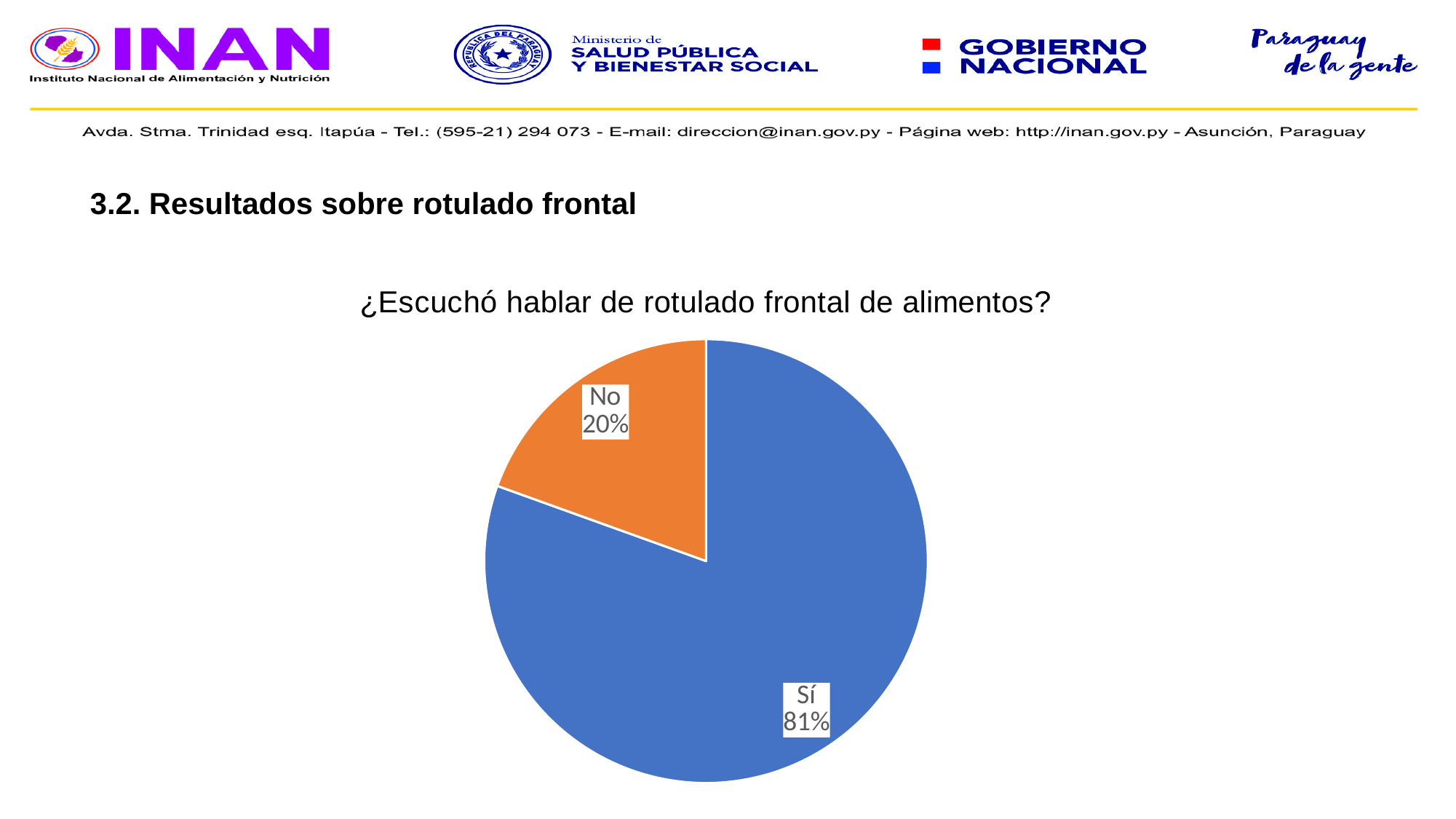
What kind of chart is shown on the slide? Pie chart How many slices does the pie chart have? 2 What is the difference in percentage points between the "Sí" and "No" slices? 61 Which slice is the largest in the pie chart? Sí What is the title of the chart? ¿Escuchó hablar de rotulado frontal de alimentos? What share of the pie does the "No" slice represent? 20% What share of the pie does the "Sí" slice represent? 81% Which is larger, the "Sí" slice or the "No" slice? Sí What colour is the "No" slice? Orange Which slice is the smallest in the pie chart? No